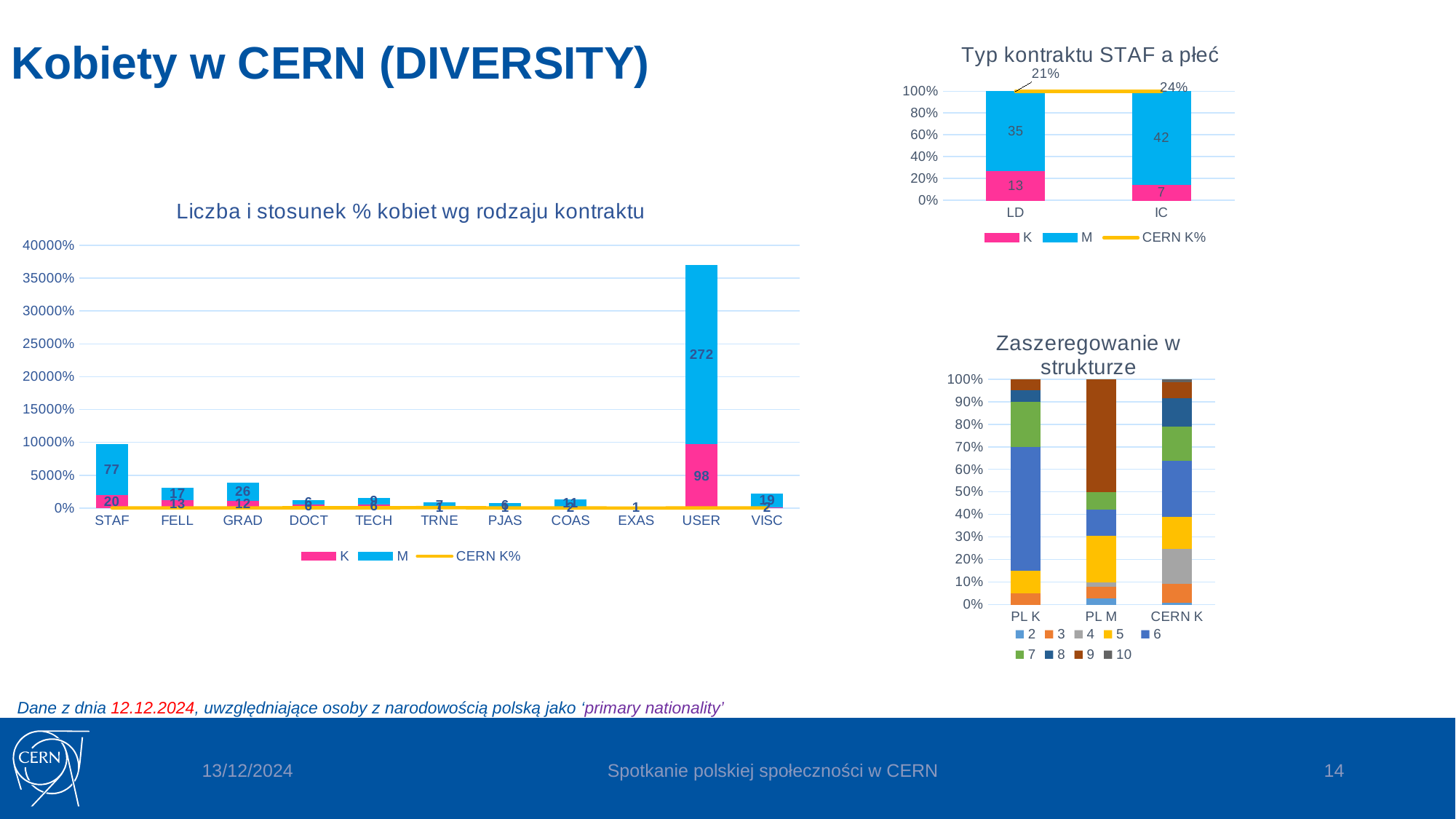
In the chart 'Liczba i stosunek % kobiet wg rodzaju kontraktu', how many contract categories are shown on the x axis? 11 In the chart 'Typ kontraktu STAF a płeć', how many series does the legend list? 3 In the chart 'Zaszeregowanie w strukturze', how many series does the legend list? 9 In the chart 'Liczba i stosunek % kobiet wg rodzaju kontraktu', what is the total of the K and M values for STAF? 97 In the chart 'Liczba i stosunek % kobiet wg rodzaju kontraktu', what is the M value for USER? 272 In the chart 'Liczba i stosunek % kobiet wg rodzaju kontraktu', what is the difference between the M and K values for USER? 174 In the chart 'Liczba i stosunek % kobiet wg rodzaju kontraktu', which is larger: the K value for FELL or the K value for GRAD? FELL In the chart 'Liczba i stosunek % kobiet wg rodzaju kontraktu', what is the K value for STAF? 20 In the chart 'Typ kontraktu STAF a płeć', what is the M value for LD? 35 In the chart 'Liczba i stosunek % kobiet wg rodzaju kontraktu', which category has the highest M value? USER In the chart 'Typ kontraktu STAF a płeć', what is the K value for IC? 7 In the chart 'Typ kontraktu STAF a płeć', what is the CERN K% value at IC? 24%